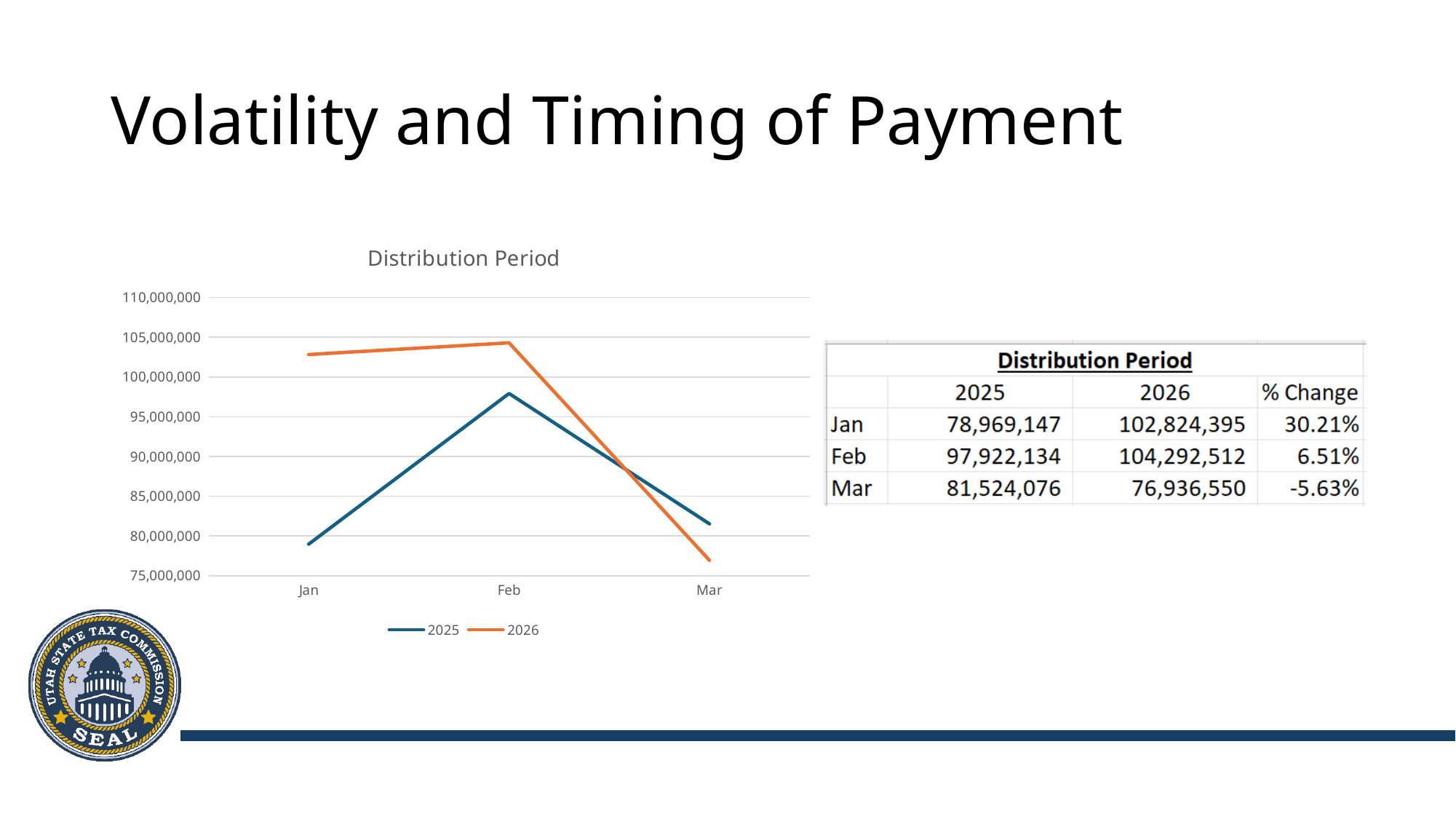
What is the difference between the 2026 and 2025 values for Jan? 23,855,248 What is the value for Jan in the 2026 series? 102,824,395 What is the value for Mar in the 2026 series? 76,936,550 How many series does the chart legend list? 2 Which is larger for Mar, the 2025 value or the 2026 value? 2025 Which month has the highest value in the 2025 series? Feb Which month has the lowest value in the 2026 series? Mar What is the value for Feb in the 2025 series? 97,922,134 What is the title of the chart? Distribution Period Is the value for Feb in the 2026 series greater or less than 100,000,000? greater How many months are plotted along the x axis of the chart? 3 What kind of chart is shown on the slide? line chart